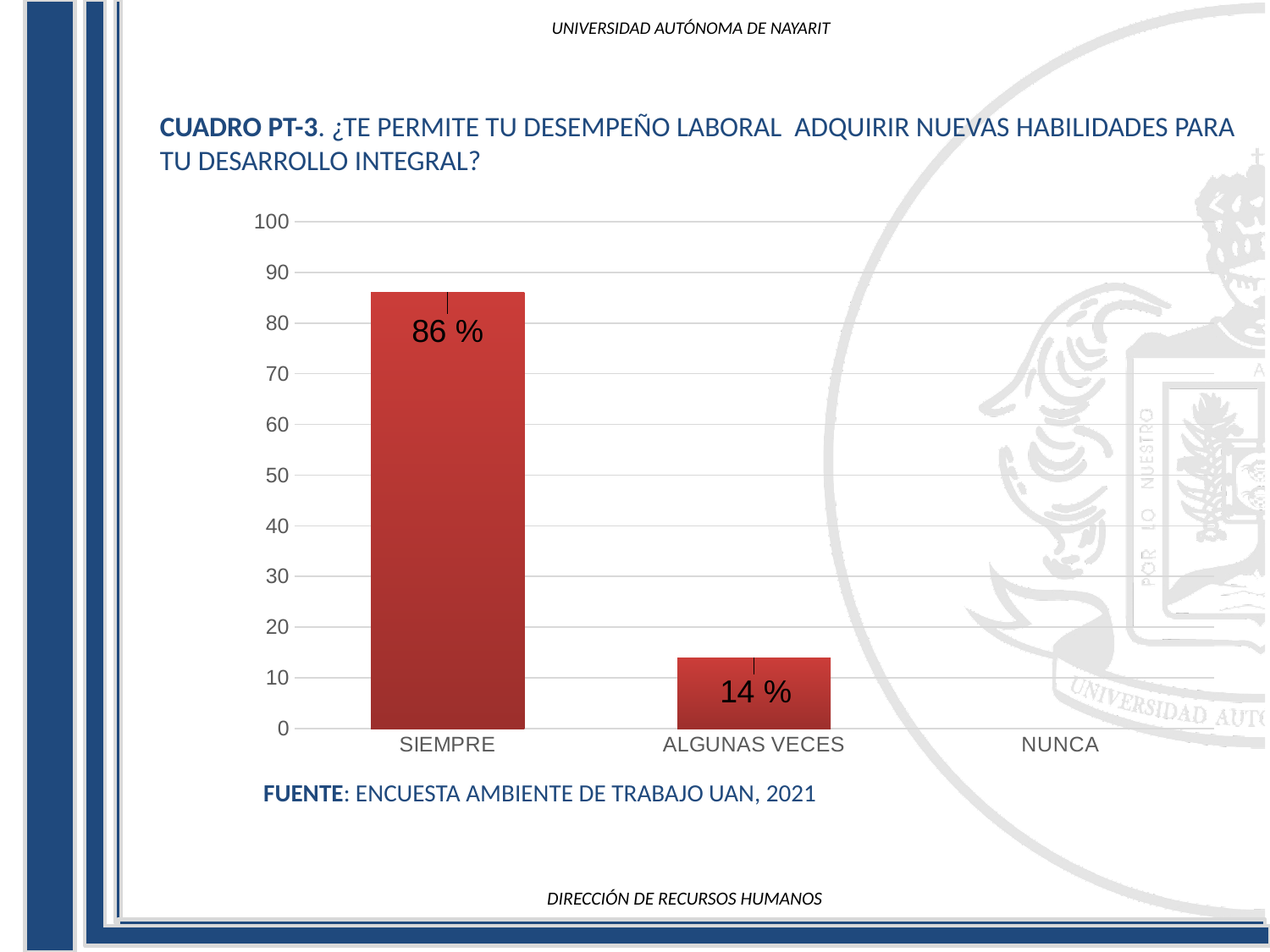
Do the values rise or fall from left to right along the x axis? Fall Is the value for ALGUNAS VECES greater or less than 20? less What kind of chart is shown on the slide? Bar chart Which category has the highest value? SIEMPRE How many categories are shown on the x axis? 3 Which is larger, the value for SIEMPRE or the value for ALGUNAS VECES? SIEMPRE What is the value shown for SIEMPRE? 86 % What is the difference between the values for SIEMPRE and ALGUNAS VECES? 72 % What is the value shown for ALGUNAS VECES? 14 % Is the value for SIEMPRE greater or less than 80? greater What is the source cited below the chart? ENCUESTA AMBIENTE DE TRABAJO UAN, 2021